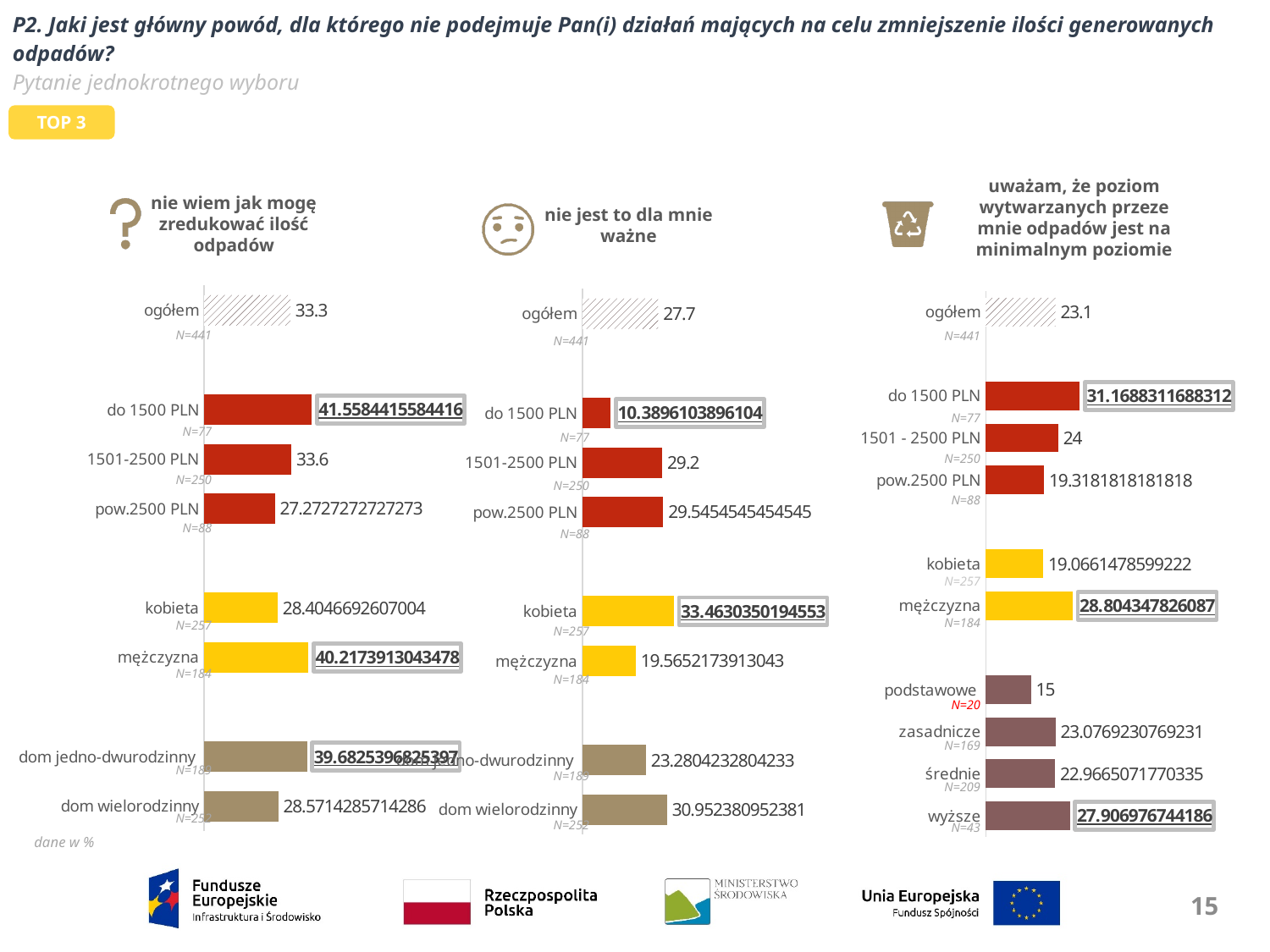
In the chart titled "uważam, że poziom wytwarzanych przeze mnie odpadów jest na minimalnym poziomie", which category has the highest value? do 1500 PLN In the chart titled "nie jest to dla mnie ważne", what is the value for ogółem? 27.7 In the chart titled "uważam, że poziom wytwarzanych przeze mnie odpadów jest na minimalnym poziomie", what is the value for podstawowe? 15 In the chart titled "nie jest to dla mnie ważne", what is the value for dom wielorodzinny? 30.952380952381 How many categories are plotted in the chart titled "uważam, że poziom wytwarzanych przeze mnie odpadów jest na minimalnym poziomie"? 10 In the chart titled "nie wiem jak mogę zredukować ilość odpadów", what is the value for do 1500 PLN? 41.5584415584416 In the chart titled "nie wiem jak mogę zredukować ilość odpadów", what is the value for ogółem? 33.3 What kind of chart is the chart titled "nie wiem jak mogę zredukować ilość odpadów"? bar chart In the chart titled "nie jest to dla mnie ważne", which is larger, kobieta or mężczyzna? kobieta In the chart titled "nie jest to dla mnie ważne", which category has the lowest value? do 1500 PLN In the chart titled "uważam, że poziom wytwarzanych przeze mnie odpadów jest na minimalnym poziomie", what is the value for 1501 - 2500 PLN? 24 In the chart titled "nie wiem jak mogę zredukować ilość odpadów", which category has the lowest value? pow.2500 PLN